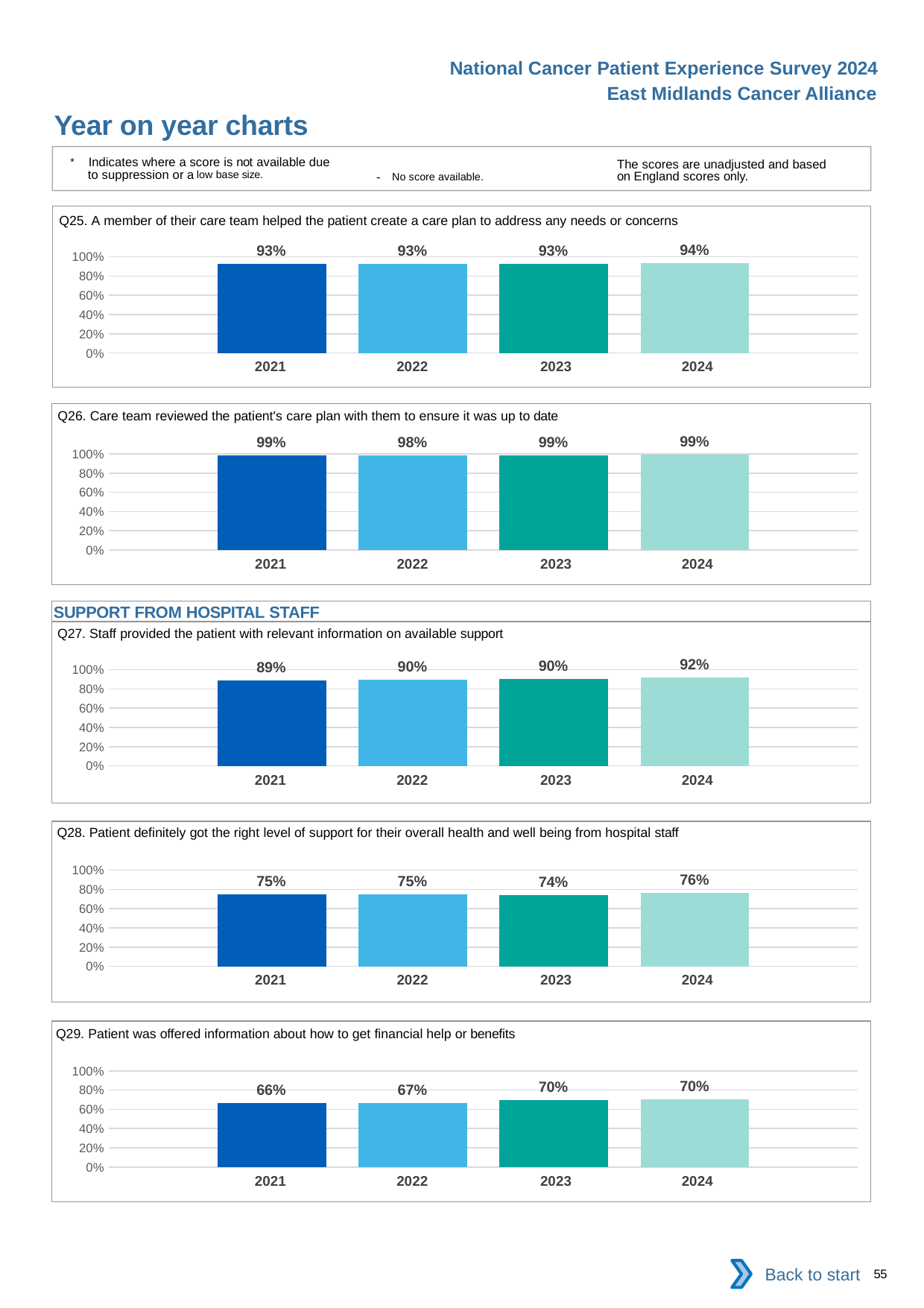
In the Q28 chart (right level of support from hospital staff), which year has the highest value? 2024 In the Q29 chart (information about financial help or benefits), is the value for 2023 larger or smaller than the value for 2022? larger In the Q26 chart (care team reviewed the patient's care plan), what is the value for 2023? 99% In the Q27 chart (relevant information on available support), what is the difference between the 2024 and 2021 values? 3% In the Q25 chart (care plan to address needs or concerns), what is the value for 2024? 94% In the Q29 chart (information about financial help or benefits), what is the value for 2021? 66% In the Q28 chart (right level of support from hospital staff), what is the difference between the 2024 and 2023 values? 2% In the Q26 chart (care team reviewed the patient's care plan), which year has the lowest value? 2022 What is the section heading printed above the Q27 chart? SUPPORT FROM HOSPITAL STAFF In the Q27 chart (relevant information on available support), do the values rise or fall from 2021 to 2024? rise What kind of chart is the Q25 chart (care plan to address needs or concerns)? bar chart How many years are shown in the Q28 chart (right level of support from hospital staff)? 4